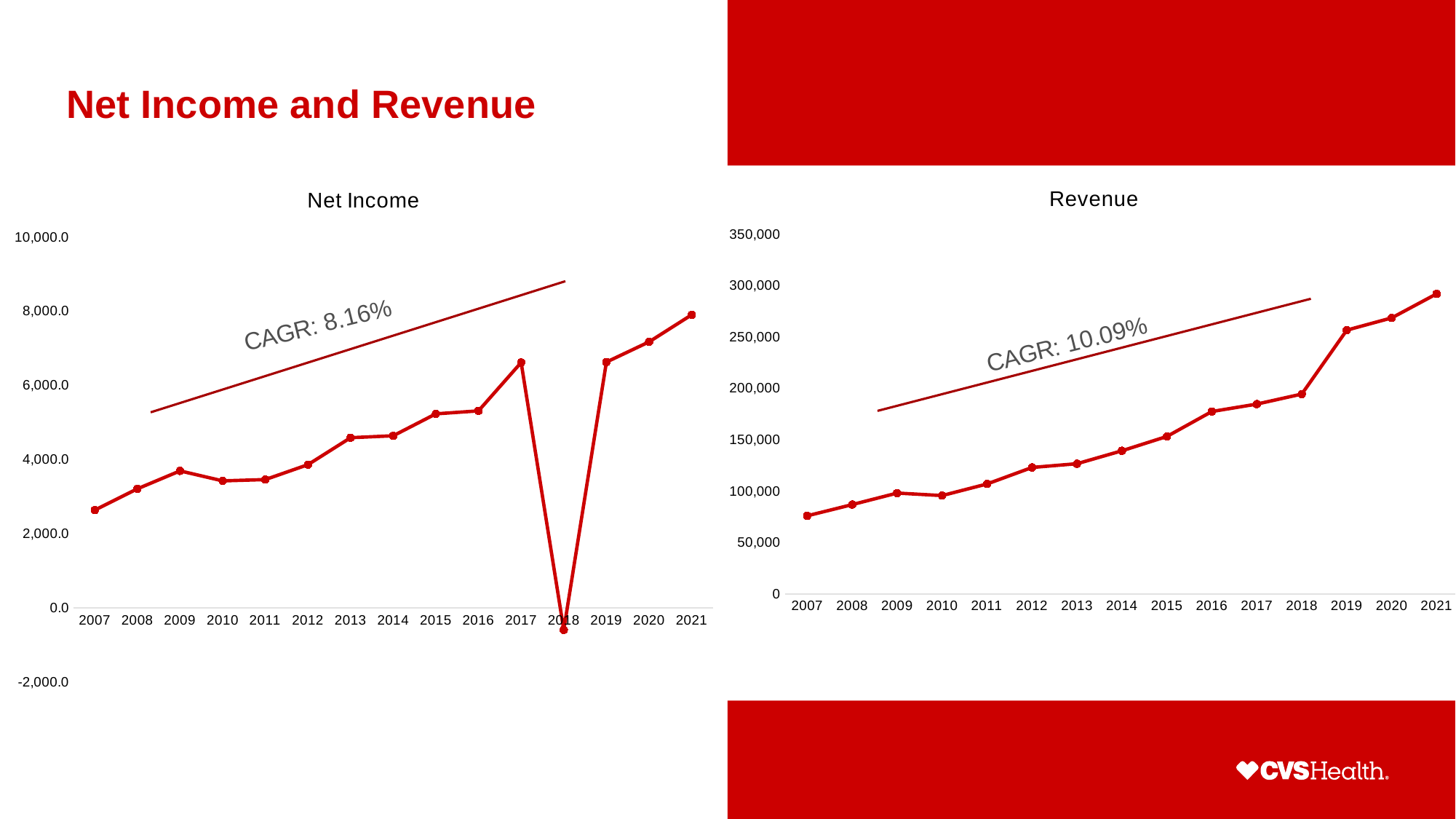
How many years are plotted on the Revenue chart? 15 In the Revenue chart, which year has the highest revenue? 2021 In the Revenue chart, which year has the lowest revenue? 2007 In the Net Income chart, is the value for 2018 greater or less than 0.0? less What CAGR is annotated on the Revenue chart? 10.09% In the Revenue chart, which year has the larger revenue, 2018 or 2019? 2019 In the Net Income chart, is the value for 2017 greater or less than 6,000.0? greater What kind of chart is the Net Income chart? line chart In the Revenue chart, is the value for 2007 greater or less than 100,000? less In the Net Income chart, which year has the lowest net income? 2018 In the Net Income chart, which year has the highest net income? 2021